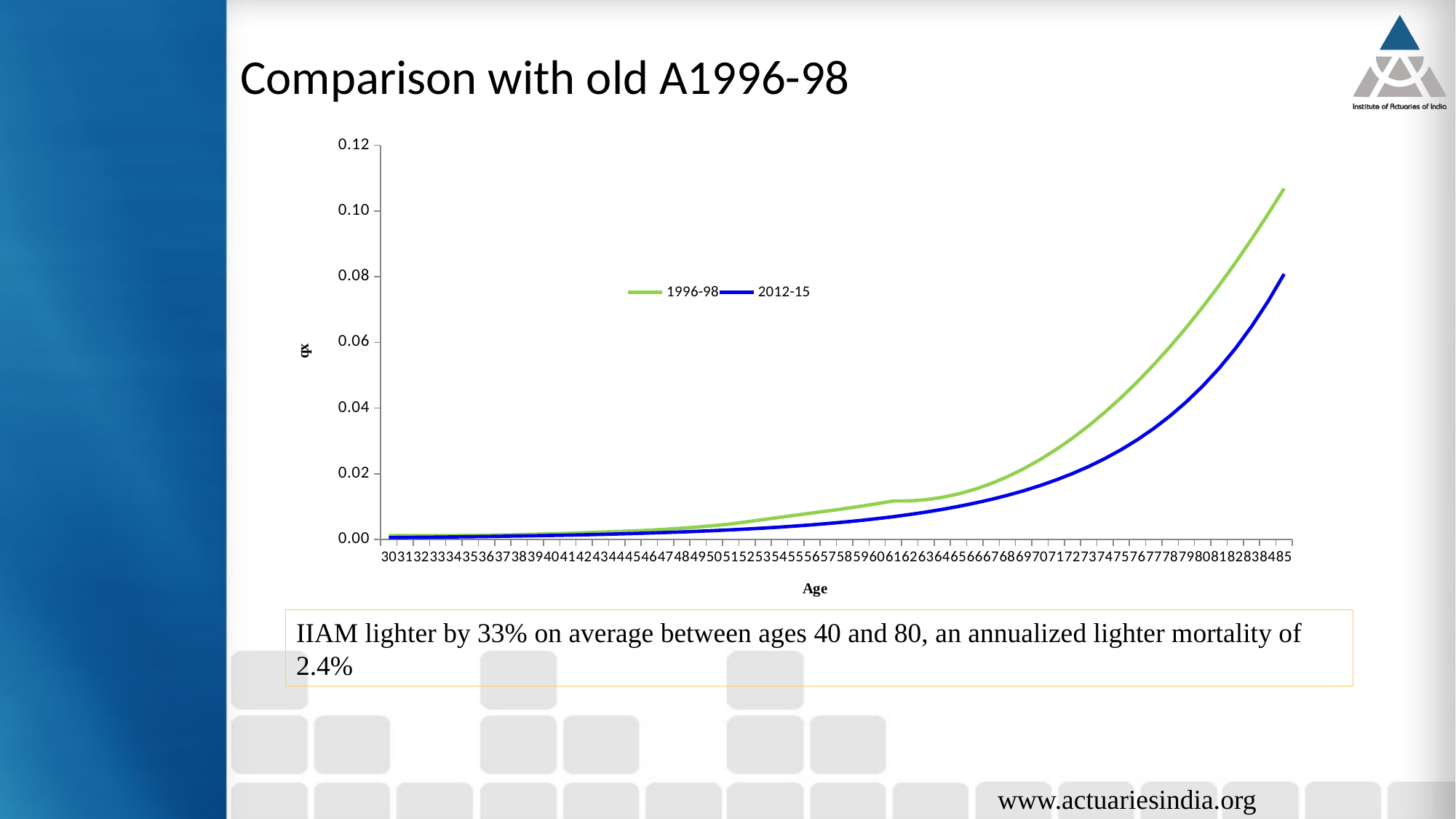
Do the qx values for the 1996-98 series rise or fall as age increases along the x axis? rise Is the qx value for the 2012-15 series at age 85 greater or less than 0.10? less At age 75, which series has the higher qx value, 1996-98 or 2012-15? 1996-98 How many series does the chart's legend list? 2 Which series is plotted in green according to the legend? 1996-98 What kind of chart is shown on the slide? line chart What is the label of the x axis? Age At age 85, which series has the higher qx value, 1996-98 or 2012-15? 1996-98 Do the qx values for the 2012-15 series rise or fall as age increases along the x axis? rise Is the qx value for the 1996-98 series at age 85 greater or less than 0.10? greater Is the qx value for the 1996-98 series at age 60 greater or less than 0.02? less